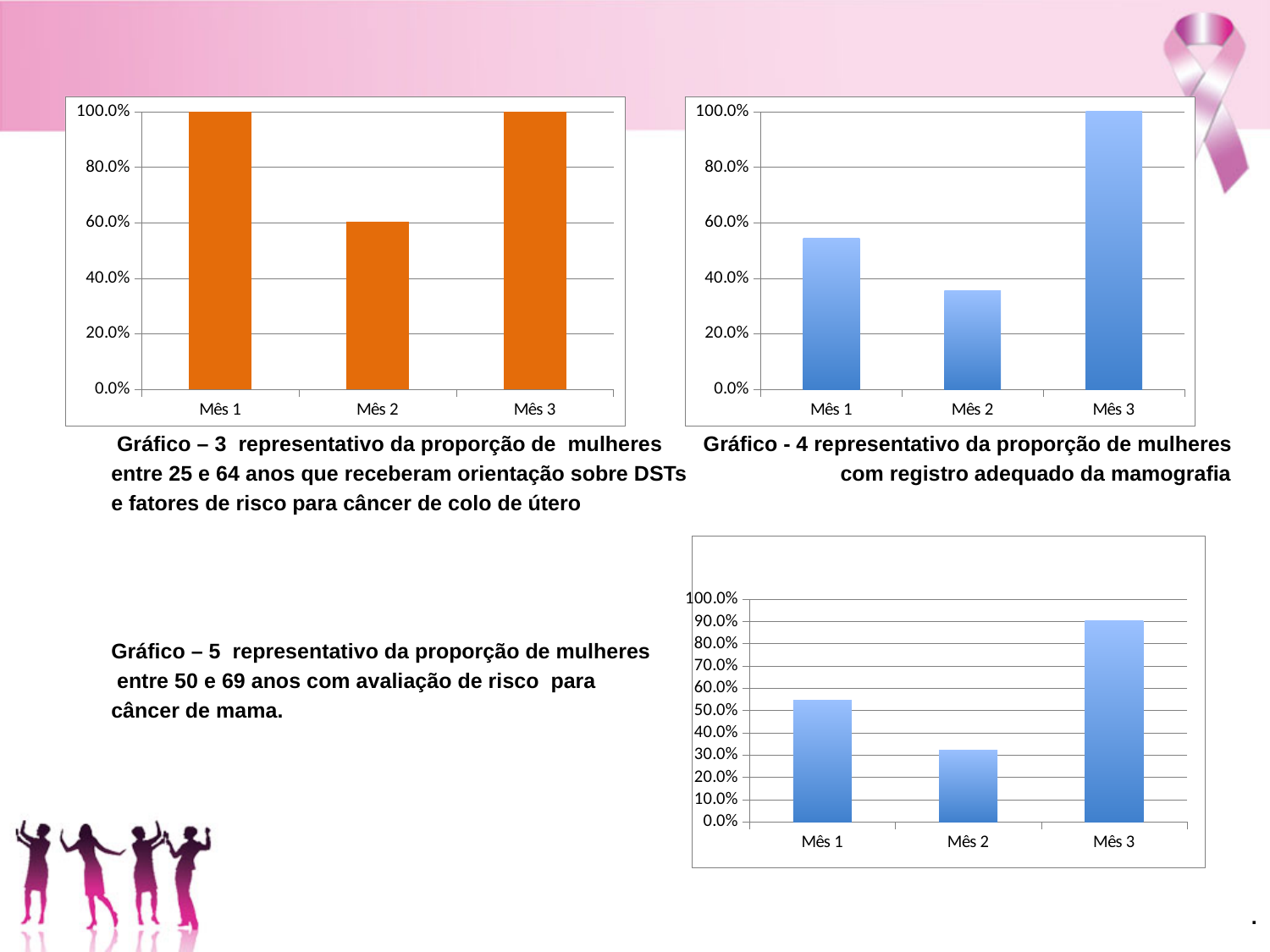
In Gráfico 4 (top-right chart), what is the value for Mês 3? 100.0% What type of chart is Gráfico 5 (bottom-right chart)? Bar chart In Gráfico 4 (top-right chart), which is larger, the value for Mês 1 or the value for Mês 2? Mês 1 In Gráfico 4 (top-right chart), is the value for Mês 2 greater or less than 40.0%? less In Gráfico 3 (top-left chart), how many months are shown on the x axis? 3 In Gráfico 3 (top-left chart), which month has the lowest value? Mês 2 In Gráfico 5 (bottom-right chart), is the value for Mês 1 greater or less than 50.0%? greater In Gráfico 3 (top-left chart), what is the value for Mês 1? 100.0% In Gráfico 4 (top-right chart), which month has the highest value? Mês 3 In Gráfico 5 (bottom-right chart), which month has the lowest value? Mês 2